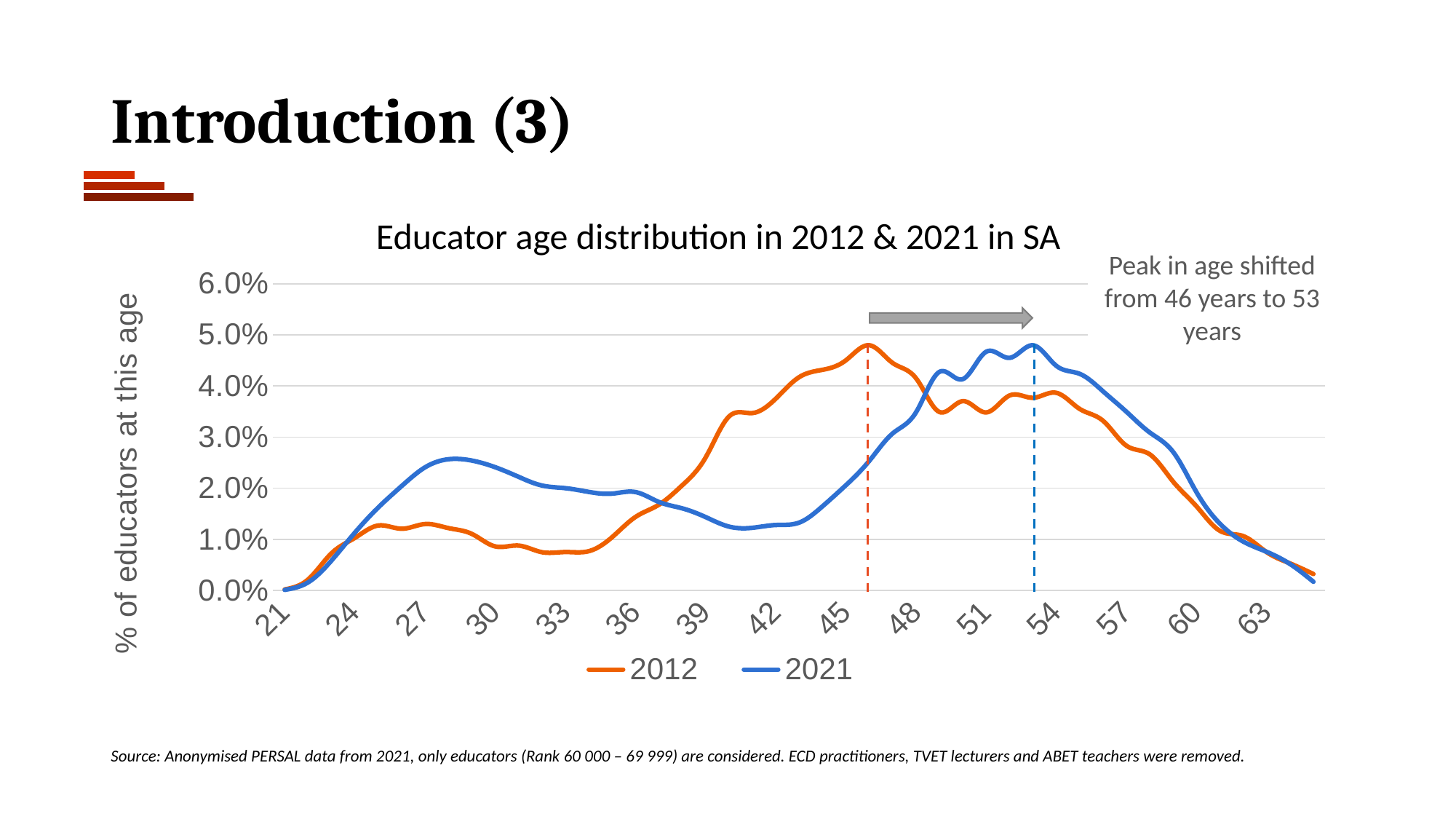
Does the 2021 series rise or fall between age 54 and age 63? fall What is the title of the chart? Educator age distribution in 2012 & 2021 in SA Is the value for the 2021 series at age 28 greater or less than 3.0%? less Is the value for the 2021 series at age 42 greater or less than 2.0%? less What kind of chart is shown on the slide? line chart According to the annotation on the chart, from what age to what age did the peak shift? from 46 years to 53 years At age 30, which series has the higher value, 2012 or 2021? 2021 Is the value for the 2012 series at age 46 greater or less than 4.0%? greater At age 45, which series has the higher value, 2012 or 2021? 2012 How many series does the legend list? 2 Does the 2012 series rise or fall between age 36 and age 46? rise